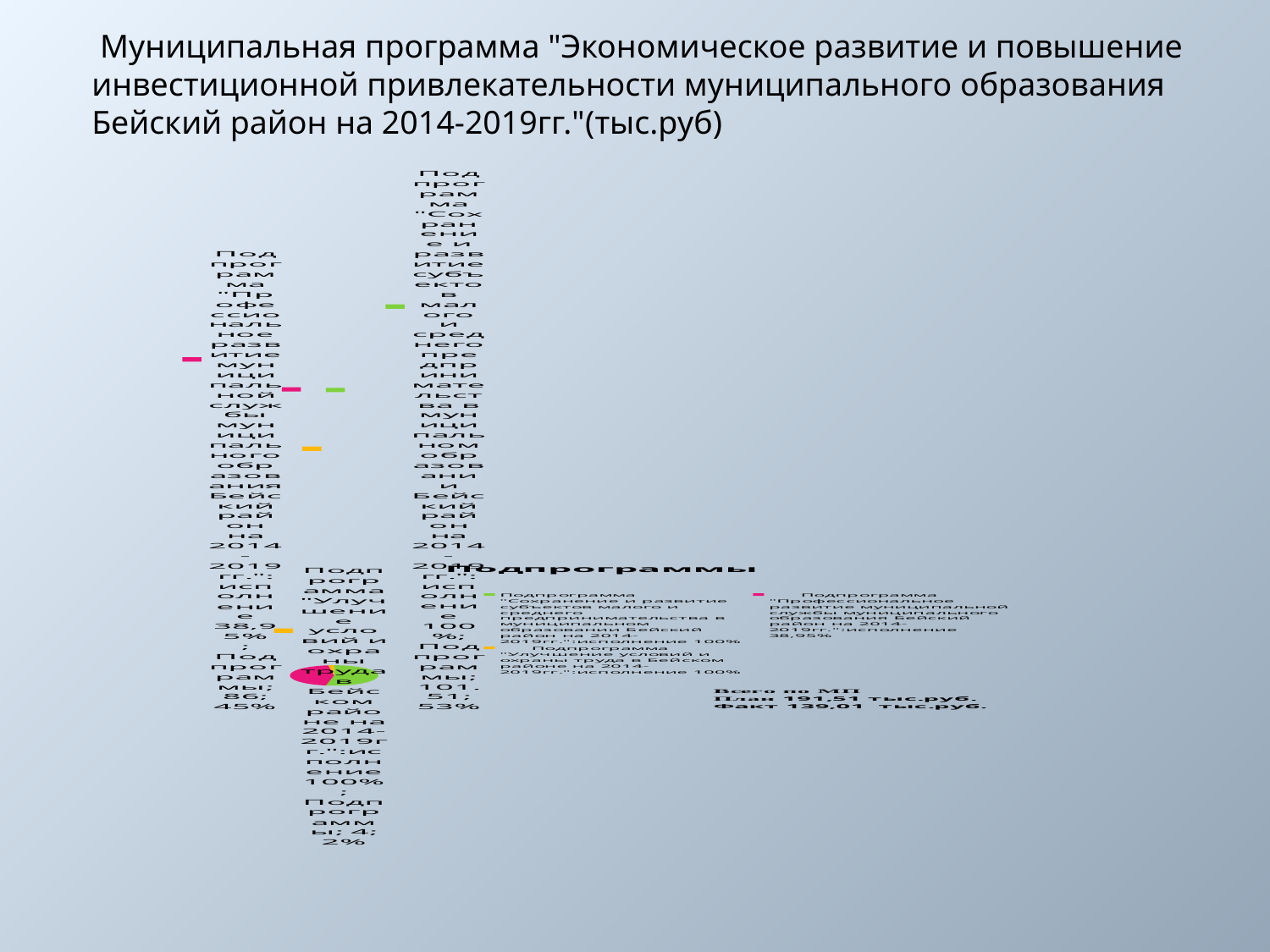
What share of the pie does the subprogram "Профессиональное развитие муниципальной службы" take? 45% Which subprogram has the smallest slice of the pie? Улучшение условий и охраны труда в Бейском районе What is the value for the subprogram "Улучшение условий и охраны труда в Бейском районе"? 4 How many slices does the pie chart have? 3 What share of the pie does the subprogram "Улучшение условий и охраны труда" take? 2% What is the value for the subprogram "Сохранение и развитие субъектов малого и среднего предпринимательства"? 101.51 How many entries does the legend "Подпрограммы" list? 3 Which subprogram has the largest slice of the pie? Сохранение и развитие субъектов малого и среднего предпринимательства What is the difference between the values for "Сохранение и развитие субъектов малого и среднего предпринимательства" (101,51) and "Профессиональное развитие муниципальной службы" (86)? 15.51 What kind of chart is shown on the slide? pie chart What is the value for the subprogram "Профессиональное развитие муниципальной службы"? 86 What colour is the slice for the subprogram "Улучшение условий и охраны труда в Бейском районе"? orange